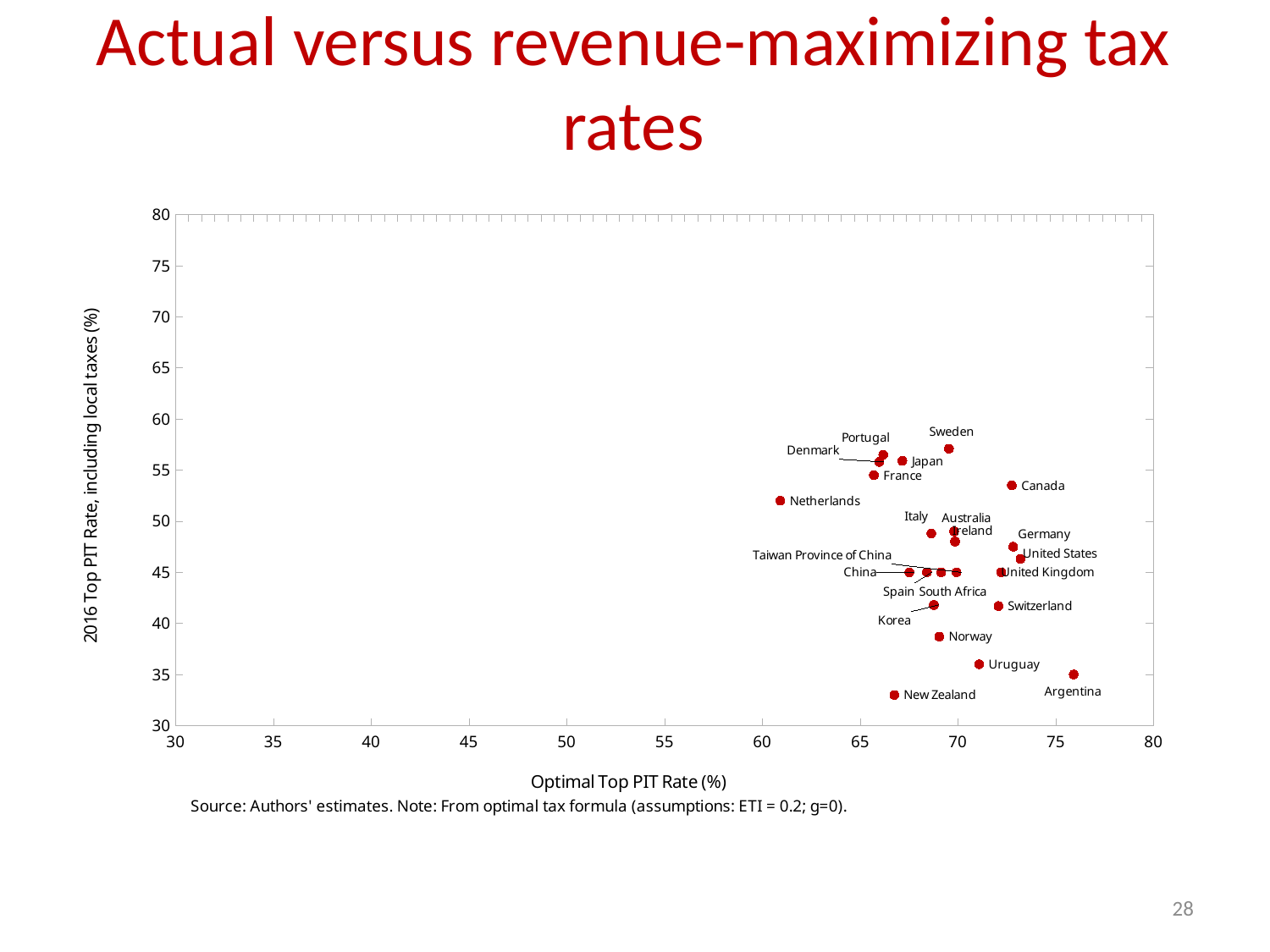
What kind of chart is shown on the slide? scatter chart Is the 2016 Top PIT Rate for Switzerland greater or less than 45? less Which country has the lowest 2016 Top PIT Rate on the chart? New Zealand Is the 2016 Top PIT Rate for Norway greater or less than 40? less Which has the higher 2016 Top PIT Rate, Norway or New Zealand? Norway Which has the higher 2016 Top PIT Rate, Canada or the Netherlands? Canada What is the title of the vertical axis? 2016 Top PIT Rate, including local taxes (%) Which country has the highest Optimal Top PIT Rate on the chart? Argentina Is the Optimal Top PIT Rate for Argentina greater or less than 75? greater Which country has the lowest Optimal Top PIT Rate on the chart? Netherlands What is the title of the horizontal axis? Optimal Top PIT Rate (%)